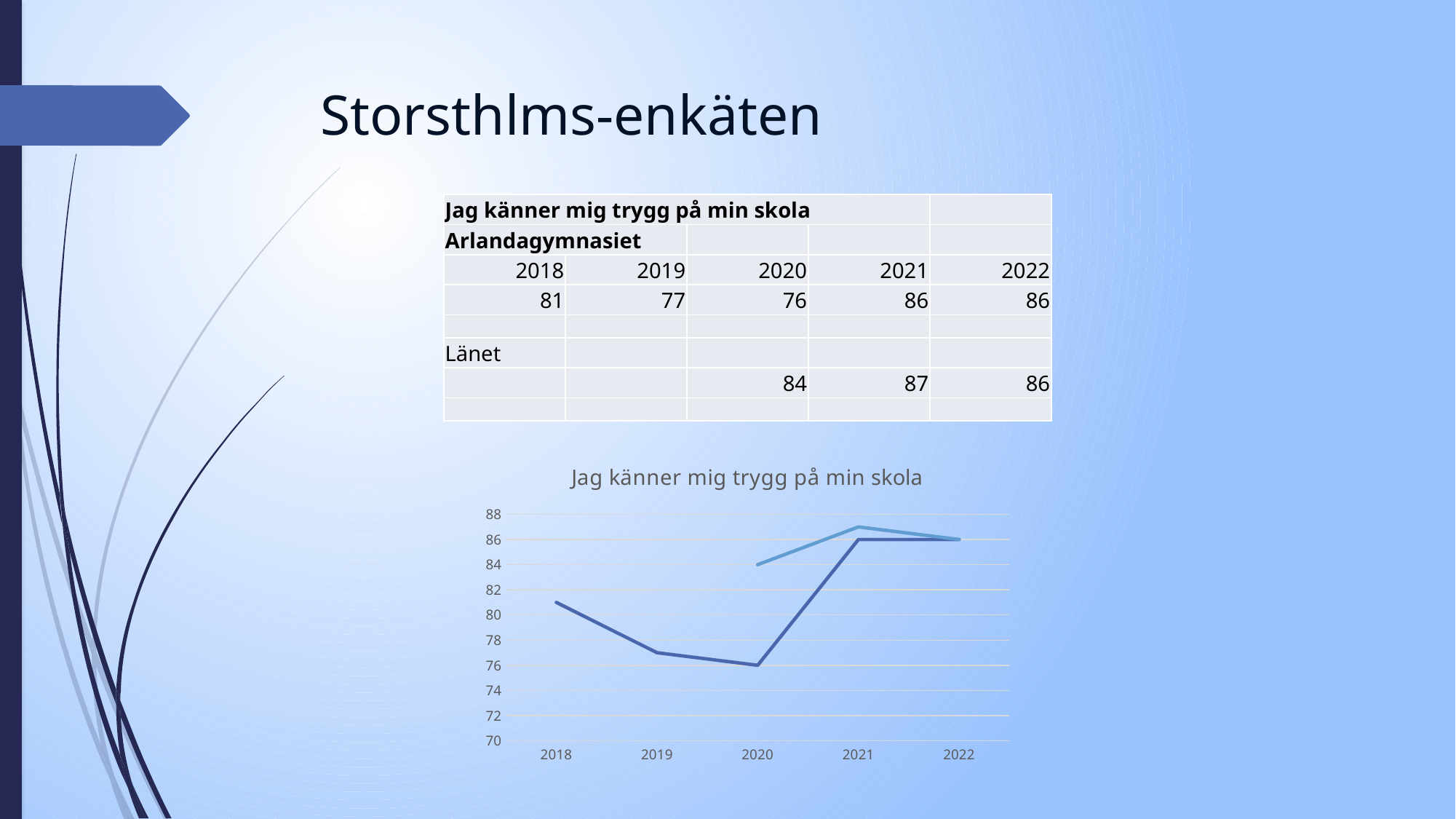
In which year is the Länet value highest? 2021 What is the value for Arlandagymnasiet in 2021? 86 What is the value for Arlandagymnasiet in 2020? 76 Does the Arlandagymnasiet line rise or fall from 2018 to 2020? fall What kind of chart is shown on the slide? line chart How many years are shown on the x axis of the chart? 5 What is the title of the chart? Jag känner mig trygg på min skola What is the value for Länet in 2020? 84 How many lines are plotted in the chart? 2 In 2020, which is higher: Länet or Arlandagymnasiet? Länet What is the value for Arlandagymnasiet in 2018? 81 In which year is the Arlandagymnasiet value lowest? 2020